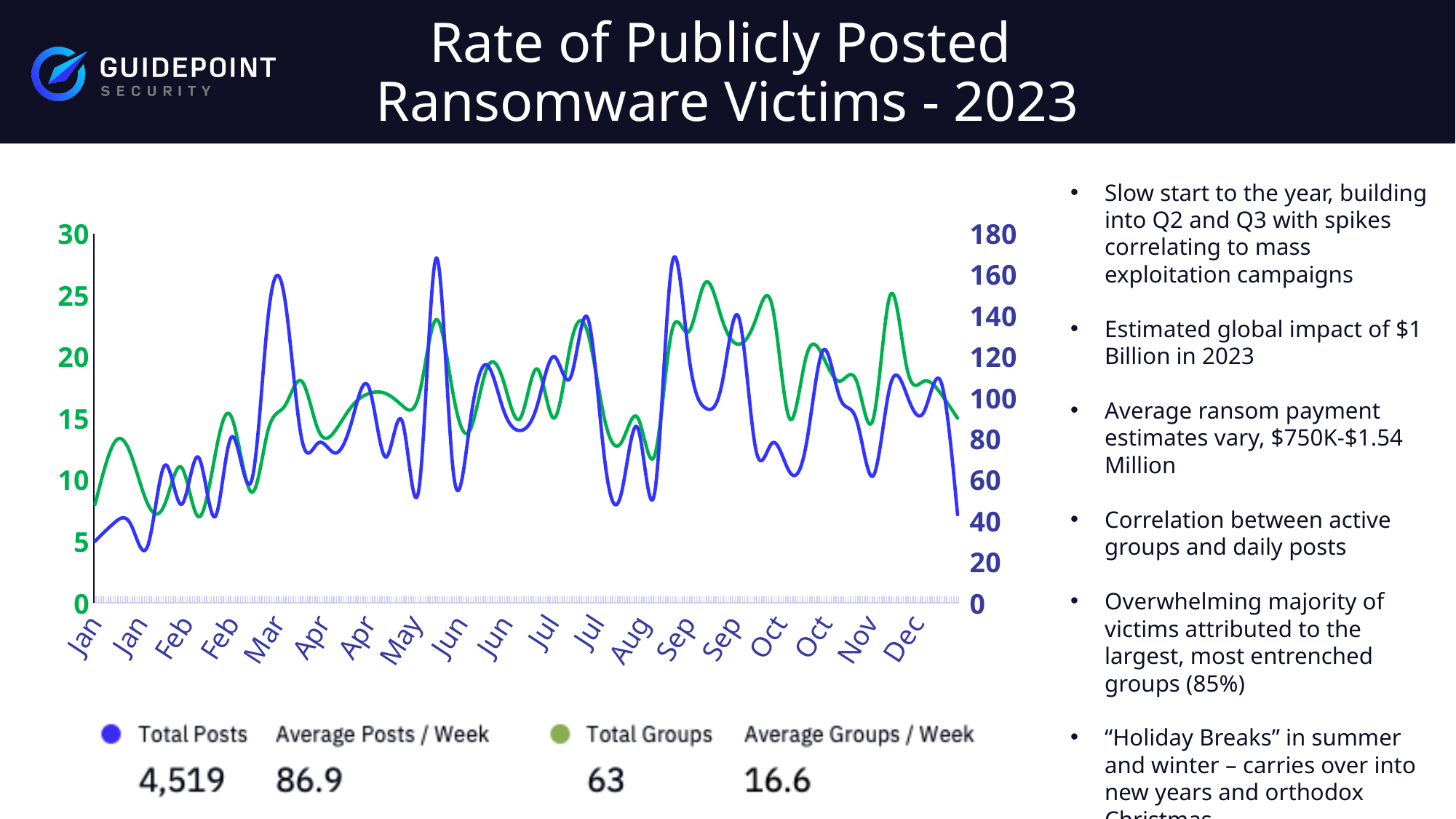
What kind of chart is shown on the slide? Line chart What is the Total Groups value shown below the chart? 63 What is the Total Posts value shown below the chart? 4,519 Is the Total Groups value at the first Jan point greater or less than 10 on the left axis? less What is the Average Posts / Week value shown below the chart? 86.9 Is the highest value of the Total Posts line (near Sep) greater or less than 160 on the right axis? greater Which colour represents the Total Groups series? Green How many series does the chart legend list? 2 Does the Total Posts line rise or fall between the first Jan label and the Mar label? Rise What is the maximum value shown on the right-hand axis? 180 What is the Average Groups / Week value shown below the chart? 16.6 Is the final Total Posts value at Dec greater or less than 60 on the right axis? less